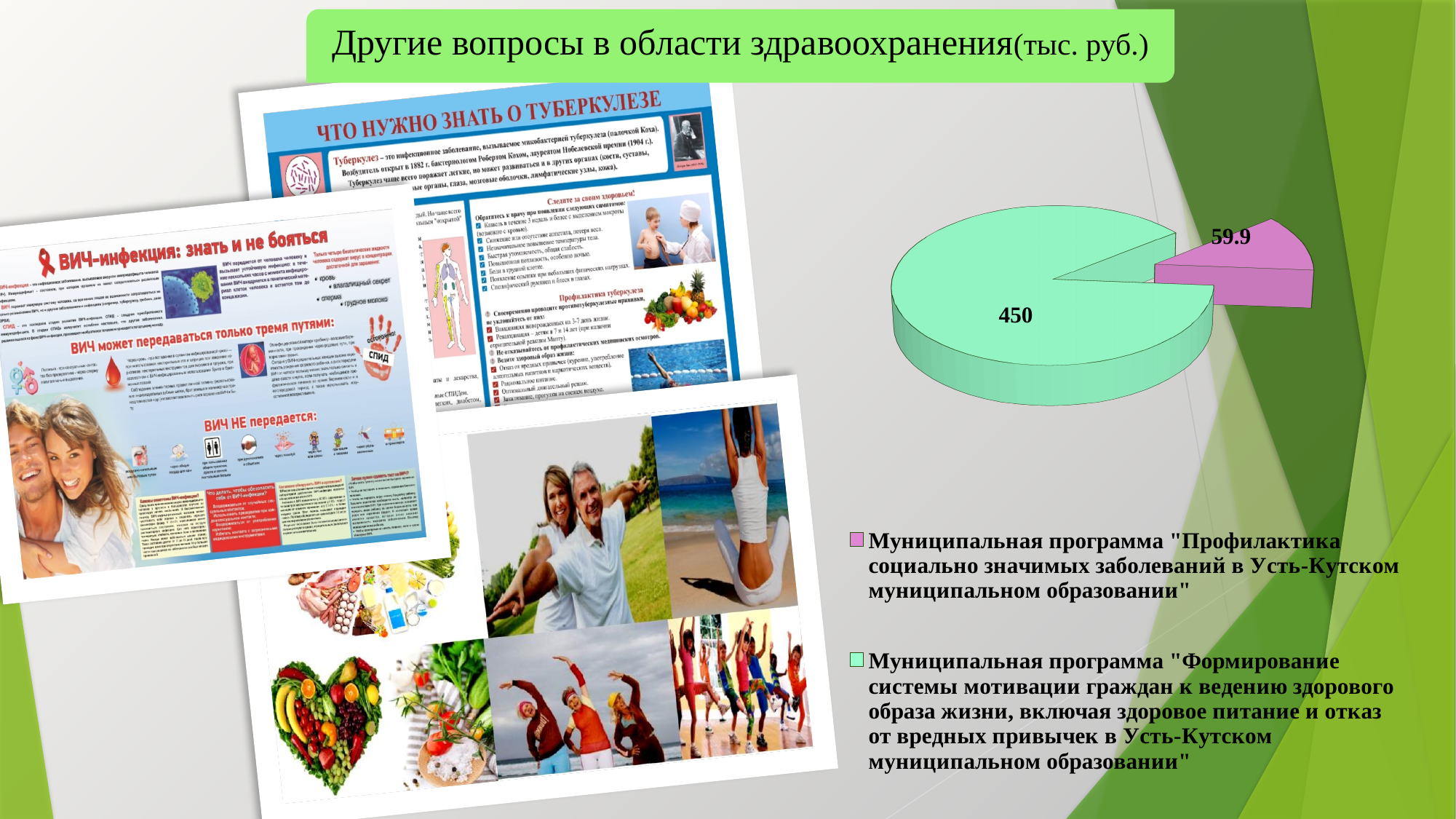
What is the value for the municipal programme "Профилактика социально значимых заболеваний в Усть-Кутском муниципальном образовании" in the pie chart? 59.9 What is the value for the municipal programme "Формирование системы мотивации граждан к ведению здорового образа жизни..." in the pie chart? 450 Which programme has the largest slice in the pie chart? Муниципальная программа "Формирование системы мотивации граждан к ведению здорового образа жизни, включая здоровое питание и отказ от вредных привычек в Усть-Кутском муниципальном образовании" Which is larger: the value for the programme on prevention of socially significant diseases (59.9) or the value for the programme on motivating citizens to a healthy lifestyle (450)? The programme on motivating citizens to a healthy lifestyle (450) What colour is the slice representing the programme "Профилактика социально значимых заболеваний" in the pie chart? Pink How many entries does the legend of the pie chart list? 2 Which programme has the smallest slice in the pie chart? Муниципальная программа "Профилактика социально значимых заболеваний в Усть-Кутском муниципальном образовании" What is the difference between the two values shown in the pie chart (450 and 59.9)? 390.1 What type of chart is shown on the slide? Pie chart How many slices does the pie chart have? 2 Which programme accounts for the larger share of the pie chart? Муниципальная программа "Формирование системы мотивации граждан к ведению здорового образа жизни, включая здоровое питание и отказ от вредных привычек в Усть-Кутском муниципальном образовании" What is the total of the two values shown in the pie chart? 509.9